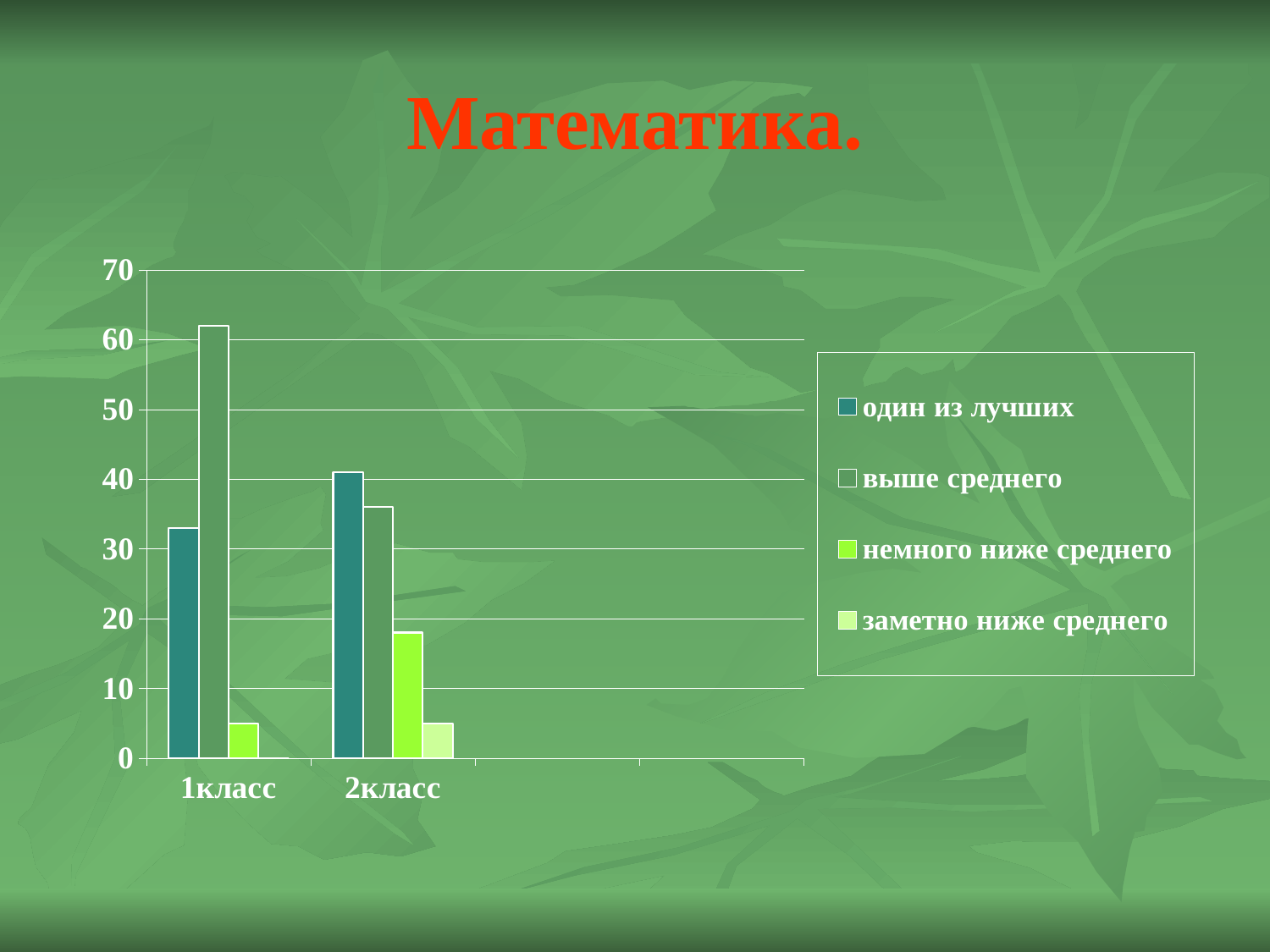
Is the value for 'выше среднего' in 1класс greater or less than 60? greater Which is larger: 'выше среднего' in 1класс or 'выше среднего' in 2класс? 1класс How many categories are shown on the x axis? 2 Which series has the highest value in 2класс? один из лучших What is the title of the slide with the chart? Математика. Is the value for 'один из лучших' in 1класс greater or less than 40? less Which legend entry is shown in the lightest green colour? заметно ниже среднего What kind of chart is shown on the slide? bar chart Is the value for 'немного ниже среднего' in 2класс greater or less than 10? greater Which series has the highest value in 1класс? выше среднего How many series does the legend list? 4